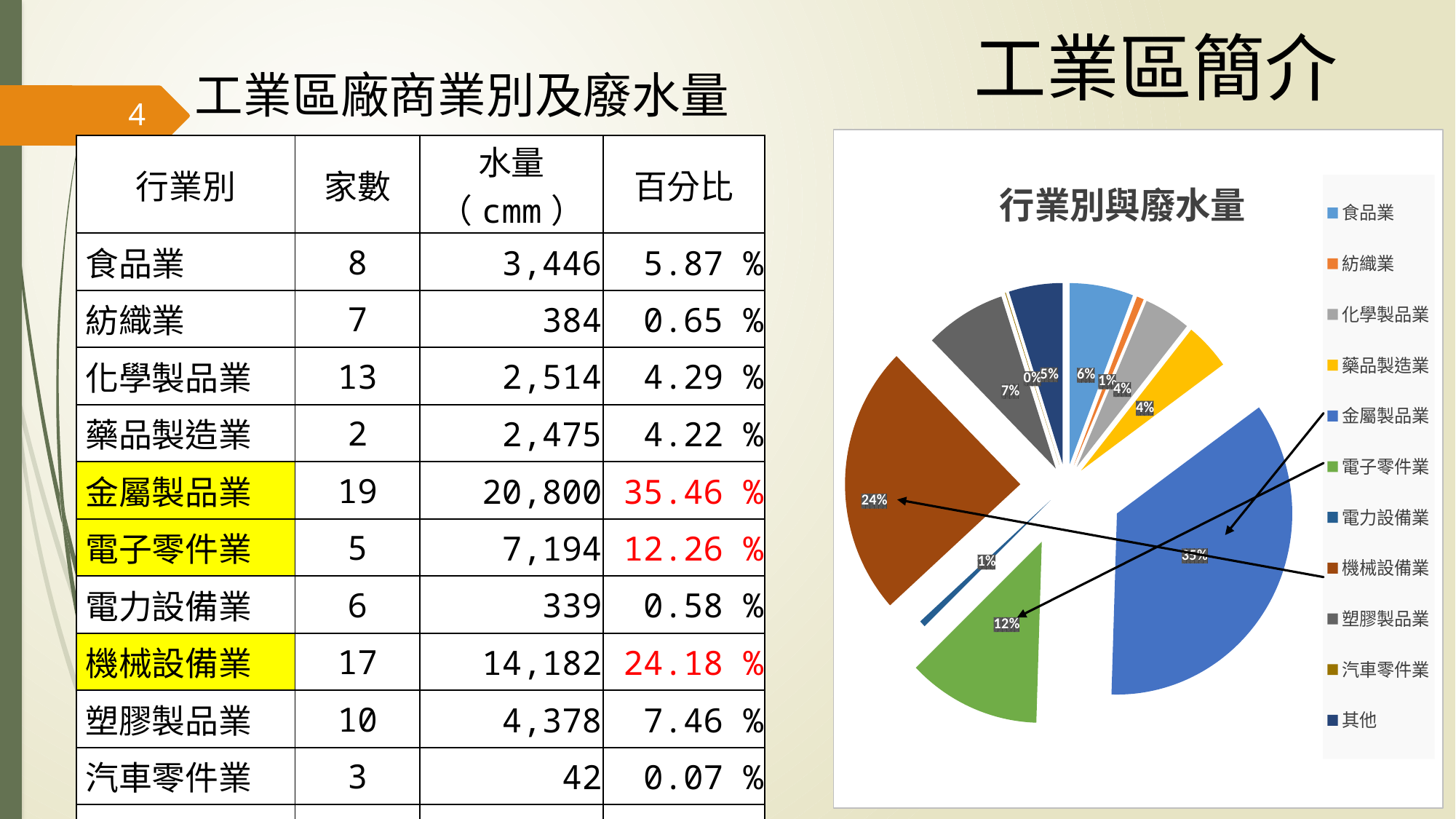
What kind of chart is shown on the slide? pie chart How many categories does the pie chart's legend list? 11 In the pie chart, which slice is larger: 機械設備業 or 電子零件業? 機械設備業 Which category has the smallest slice in the pie chart? 汽車零件業 In the pie chart, what share is labelled for 機械設備業? 24% Which category has the largest slice in the pie chart? 金屬製品業 What is the title of the pie chart? 行業別與廢水量 In the pie chart, what share is labelled for 食品業? 6% In the pie chart, what share is labelled for 金屬製品業? 35% In the pie chart, what is the difference between the labelled shares of 金屬製品業 and 機械設備業? 11%